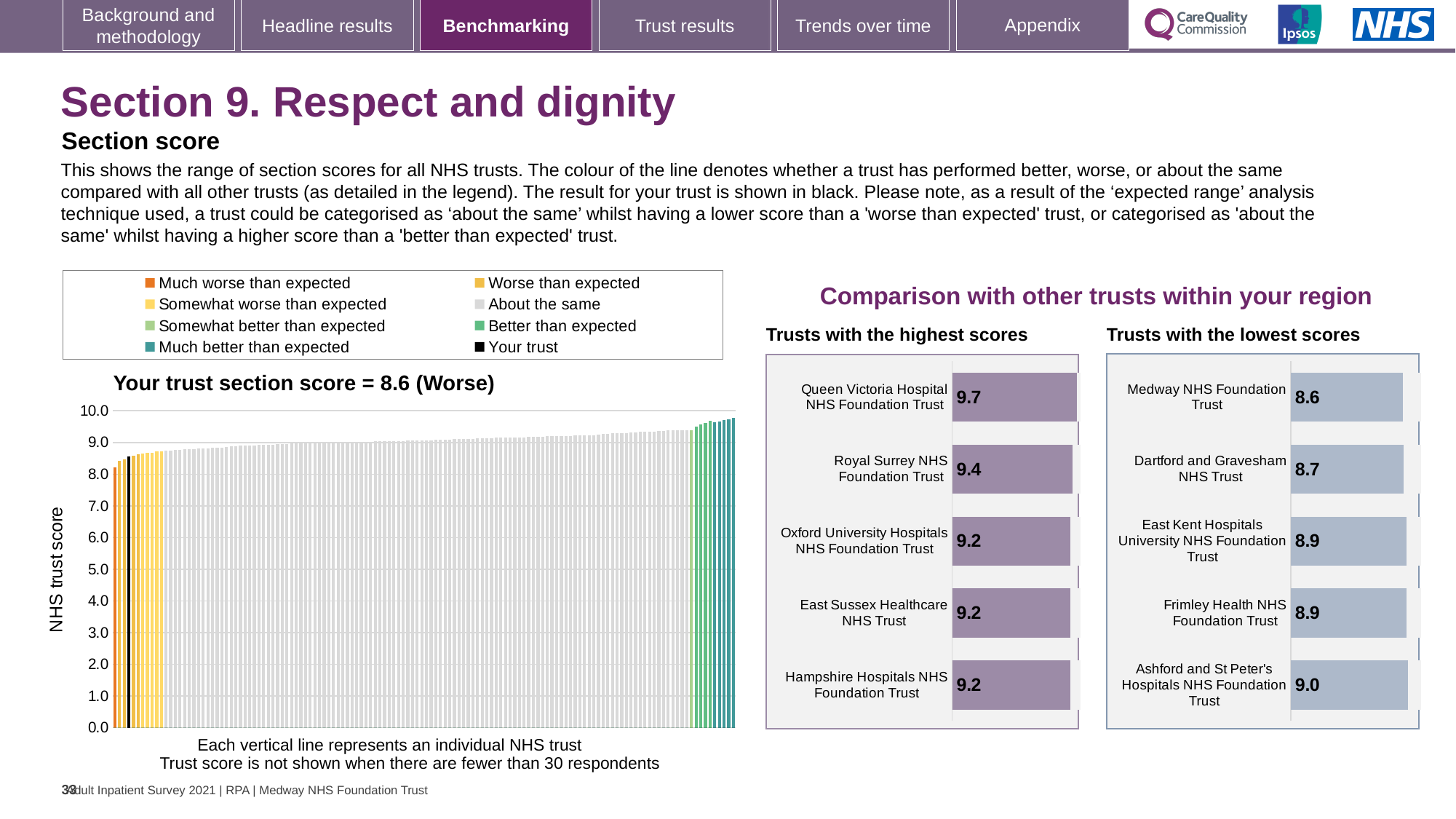
In the 'Your trust section score' chart, what is the section score for your trust? 8.6 How many entries does the legend above the 'Your trust section score' chart list? 8 In the 'Trusts with the highest scores' chart, what is the score for Queen Victoria Hospital NHS Foundation Trust? 9.7 In the 'Trusts with the lowest scores' chart, what is the score for Dartford and Gravesham NHS Trust? 8.7 In the 'Trusts with the lowest scores' chart, which trust has the lowest score? Medway NHS Foundation Trust In the 'Your trust section score' chart, do the trust scores rise or fall from left to right along the x axis? rise In the 'Trusts with the highest scores' chart, which trust has the highest score? Queen Victoria Hospital NHS Foundation Trust In the 'Trusts with the highest scores' chart, what is the difference between the scores of Queen Victoria Hospital NHS Foundation Trust and Royal Surrey NHS Foundation Trust? 0.3 In the 'Trusts with the lowest scores' chart, what is the difference between the scores of Ashford and St Peter's Hospitals NHS Foundation Trust and Medway NHS Foundation Trust? 0.4 In the 'Trusts with the highest scores' chart, how many trusts are shown? 5 In the 'Trusts with the lowest scores' chart, which has the larger score: Medway NHS Foundation Trust or East Kent Hospitals University NHS Foundation Trust? East Kent Hospitals University NHS Foundation Trust In the 'Trusts with the lowest scores' chart, which trust has the highest score? Ashford and St Peter's Hospitals NHS Foundation Trust